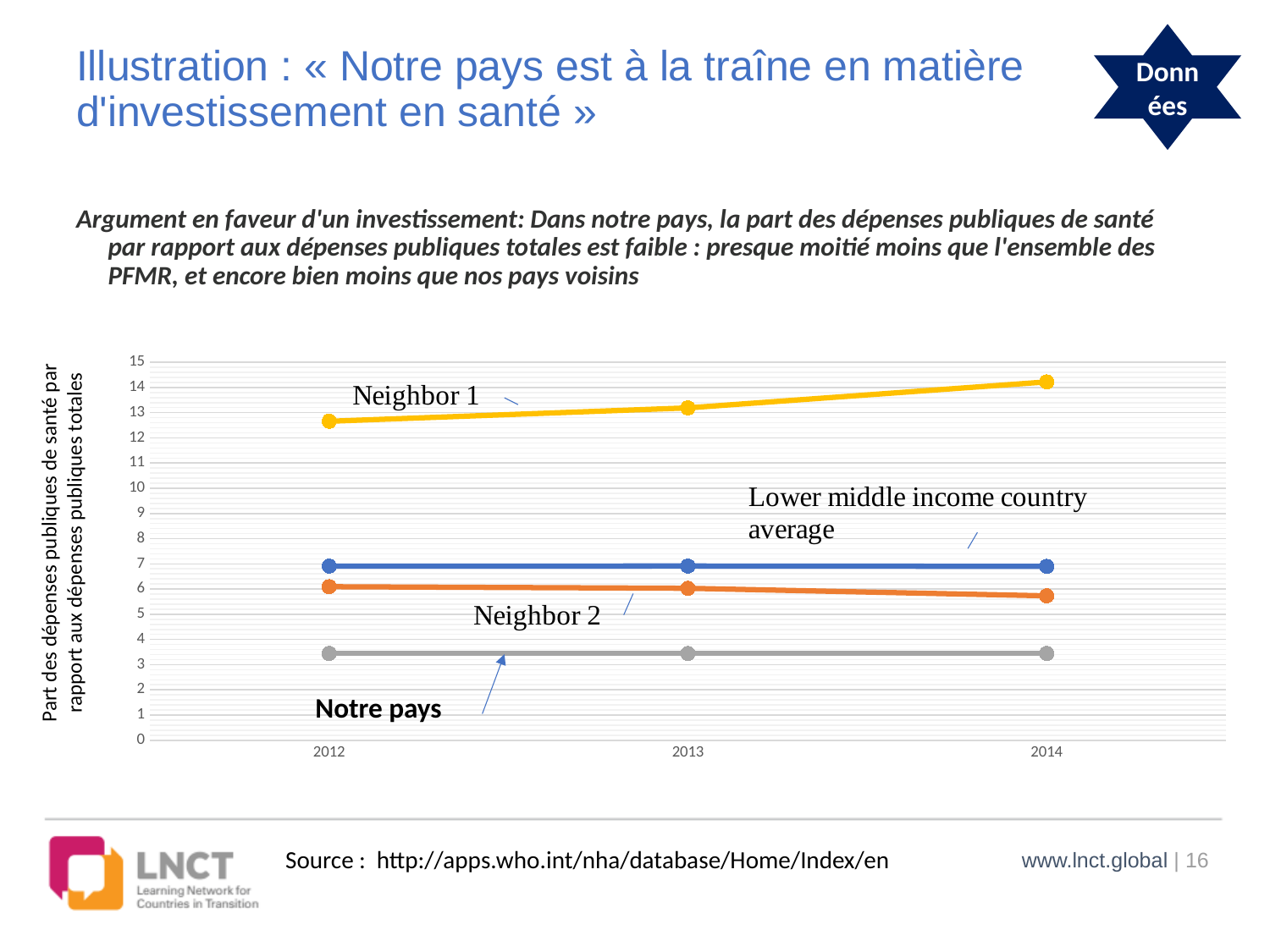
In 2012, which is larger: the value for Notre pays or the value for Neighbor 2? Neighbor 2 Which series has the lowest values across all years in the chart? Notre pays What is the label of the y axis of the chart? Part des dépenses publiques de santé par rapport aux dépenses publiques totales How many years are shown on the x axis of the chart? 3 Is the value for Notre pays in 2013 greater or less than 4? less Do the values for Neighbor 1 rise or fall from 2012 to 2014? rise Is the value for Neighbor 1 in 2012 greater or less than 12? greater In 2014, which is larger: the value for Neighbor 2 or the Lower middle income country average? Lower middle income country average Is the value for Neighbor 1 in 2014 greater or less than 14? greater Which series has the highest values across all years in the chart? Neighbor 1 What kind of chart is shown on the slide? line chart